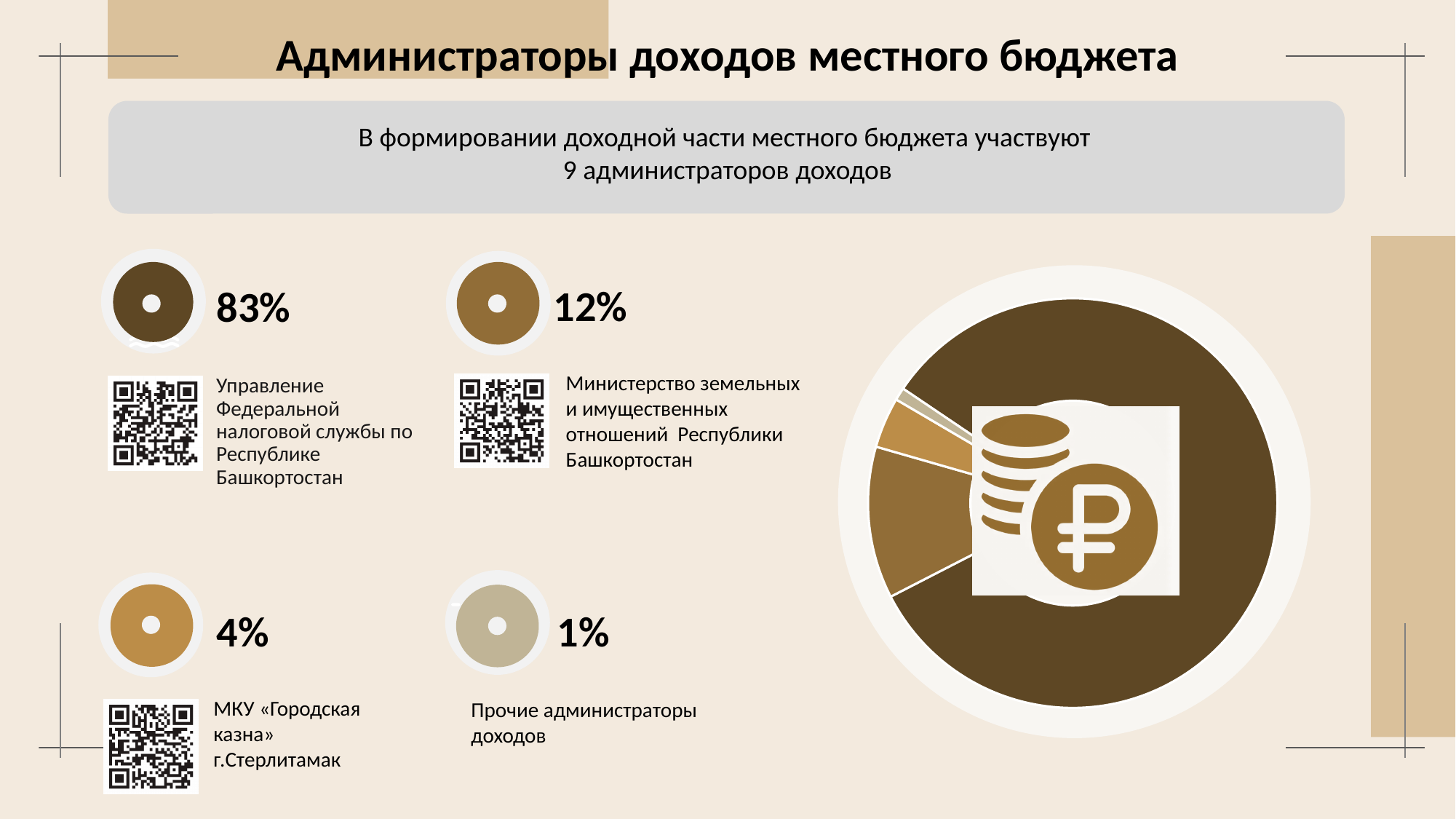
Сколько категорий показано на круговой диаграмме? 4 Какая категория имеет наименьшую долю? Прочие администраторы доходов Какая доля приходится на прочих администраторов доходов? 1% Что больше: доля МКУ «Городская казна» или доля прочих администраторов доходов? МКУ «Городская казна» Как называется слайд с диаграммой? Администраторы доходов местного бюджета На сколько процентных пунктов доля Управления ФНС больше доли Министерства земельных и имущественных отношений? 71 Какая доля приходится на Министерство земельных и имущественных отношений Республики Башкортостан? 12% Какая доля приходится на МКУ «Городская казна» г.Стерлитамак? 4% Какой тип диаграммы показан на слайде? Кольцевая диаграмма Сколько администраторов доходов участвуют в формировании доходной части местного бюджета согласно слайду? 9 Какой администратор доходов имеет наибольшую долю? Управление Федеральной налоговой службы по Республике Башкортостан Какая доля приходится на Управление Федеральной налоговой службы по Республике Башкортостан? 83%